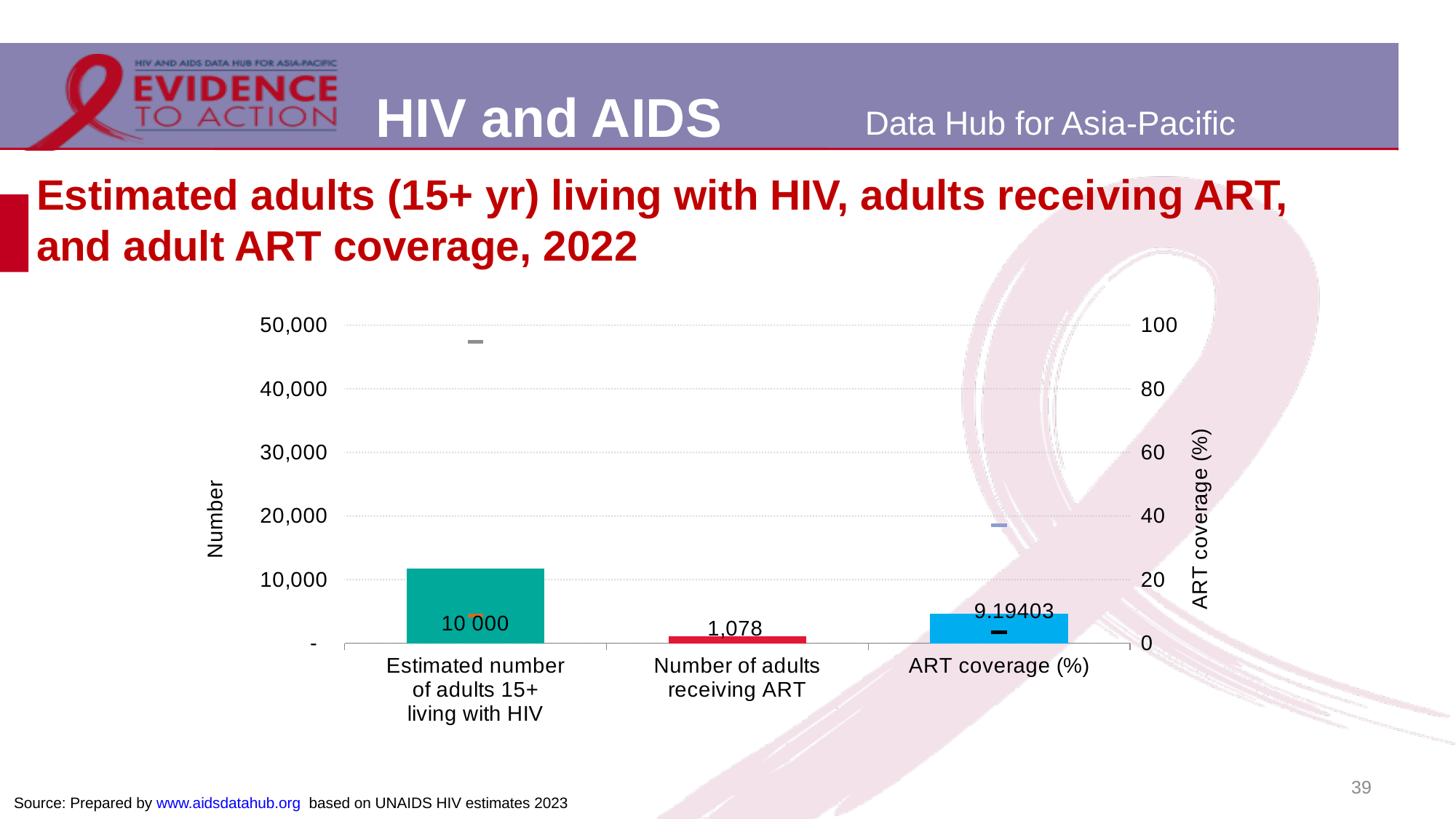
Which category has the tallest bar on the chart? Estimated number of adults 15+ living with HIV How many categories are shown on the x axis of the chart? 3 Is the value for ART coverage (%) greater or less than 20 on the right axis? less What value is labelled for ART coverage (%) on the chart? 9.19403 Which is larger: the estimated number of adults 15+ living with HIV or the number of adults receiving ART? Estimated number of adults 15+ living with HIV Is the value for the estimated number of adults 15+ living with HIV greater or less than 20,000 on the left axis? less What is the title of the left vertical axis of the chart? Number What is the difference between the estimated number of adults 15+ living with HIV and the number of adults receiving ART? 8,922 What is the title of the right vertical axis of the chart? ART coverage (%) What kind of chart is shown on the slide? Bar chart What is the number of adults receiving ART shown on the chart? 1,078 What is the estimated number of adults 15+ living with HIV shown on the chart? 10 000